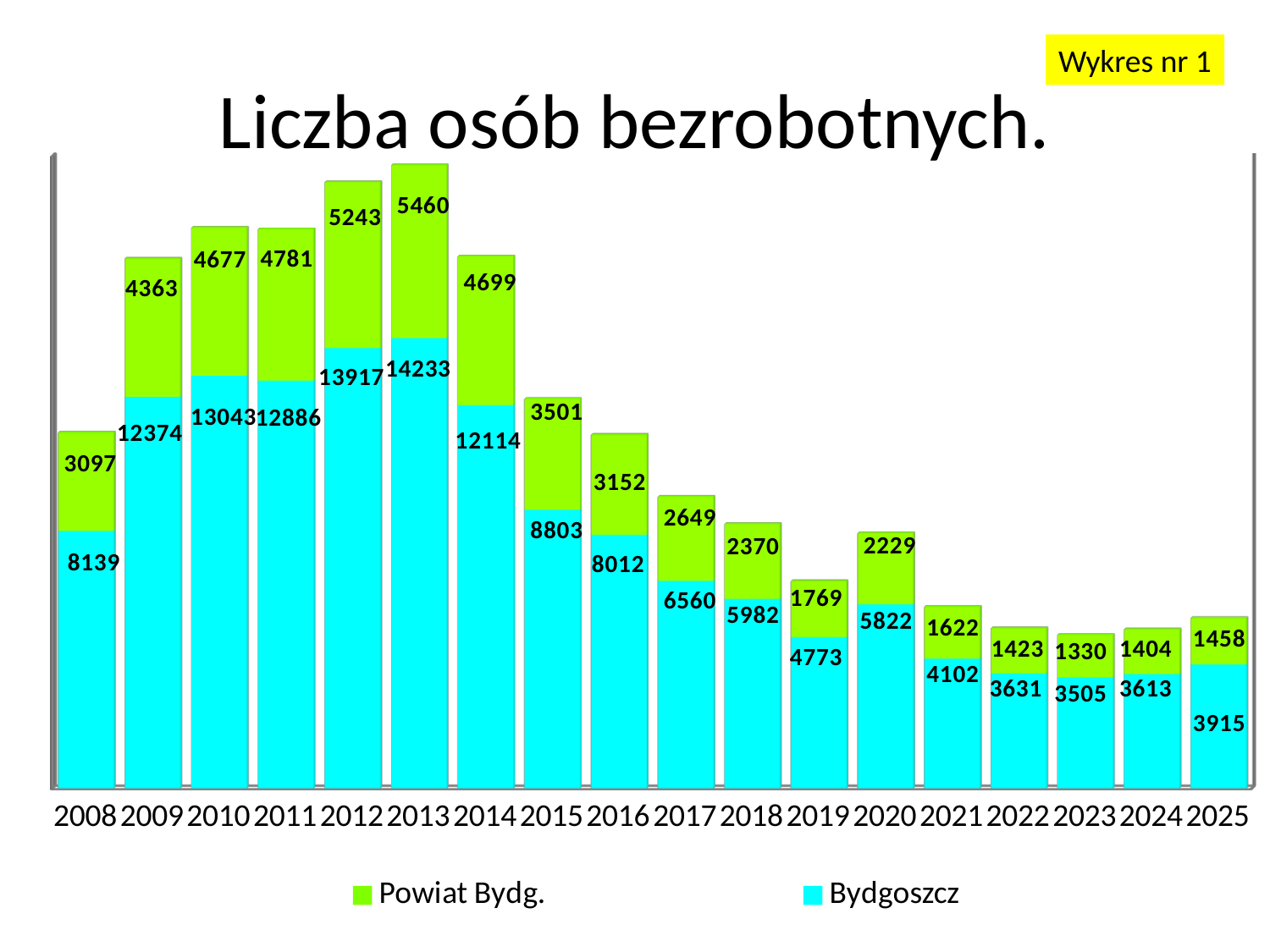
In which year is the Bydgoszcz value the highest? 2013 How many series does the legend list? 2 How many years are shown on the x axis? 18 Do the Bydgoszcz values rise or fall from 2013 to 2023? Fall What is the value for Bydgoszcz in 2013? 14233 Which year has the larger Bydgoszcz value, 2019 or 2020? 2020 What is the total of the stacked bar for 2013? 19693 What is the value for Powiat Bydg. in 2008? 3097 What is the difference between the Bydgoszcz values for 2013 and 2012? 316 What type of chart is shown on the slide? Stacked bar chart What is the title of the chart? Liczba osób bezrobotnych. In which year is the Powiat Bydg. value the lowest? 2023